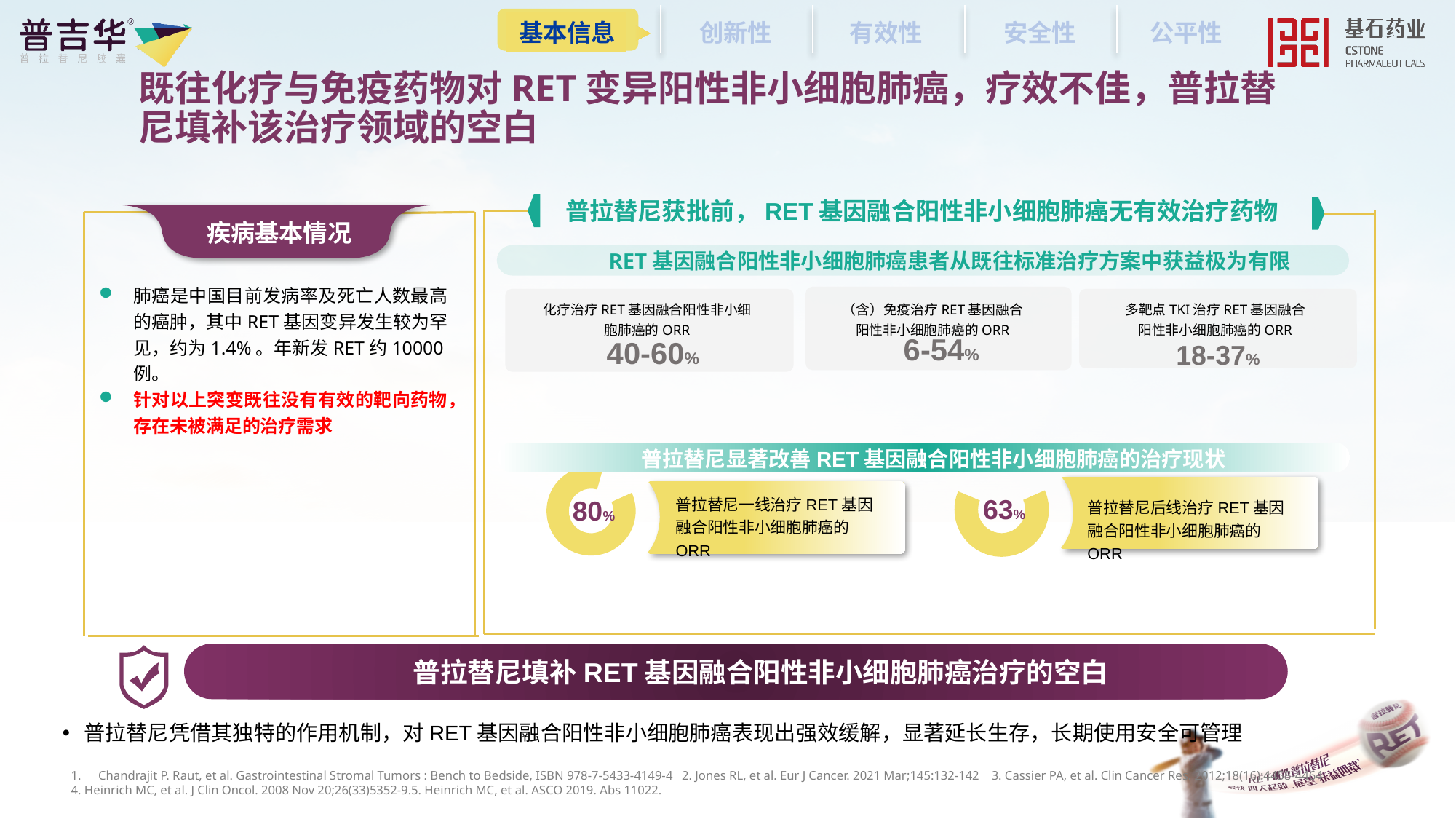
What does the right donut chart with the value 63% represent, according to its label? 普拉替尼后线治疗 RET 基因融合阳性非小细胞肺癌的 ORR On the left donut chart (普拉替尼一线治疗 RET 基因融合阳性非小细胞肺癌的 ORR), what value is shown? 80% On the right donut chart (普拉替尼后线治疗 RET 基因融合阳性非小细胞肺癌的 ORR), what value is shown? 63% How many donut charts are shown under the heading 普拉替尼显著改善 RET 基因融合阳性非小细胞肺癌的治疗现状? 2 What is the difference between the ORR shown on the left donut chart (80%) and the ORR shown on the right donut chart (63%)? 17% Which donut chart shows the larger ORR value, the left one (一线治疗) or the right one (后线治疗)? The left one (一线治疗), 80% What colour is the filled portion of the donut charts showing the 80% and 63% values? Yellow What kind of chart is used to display the 80% and 63% ORR values in the lower section of the slide? Pie (donut) chart